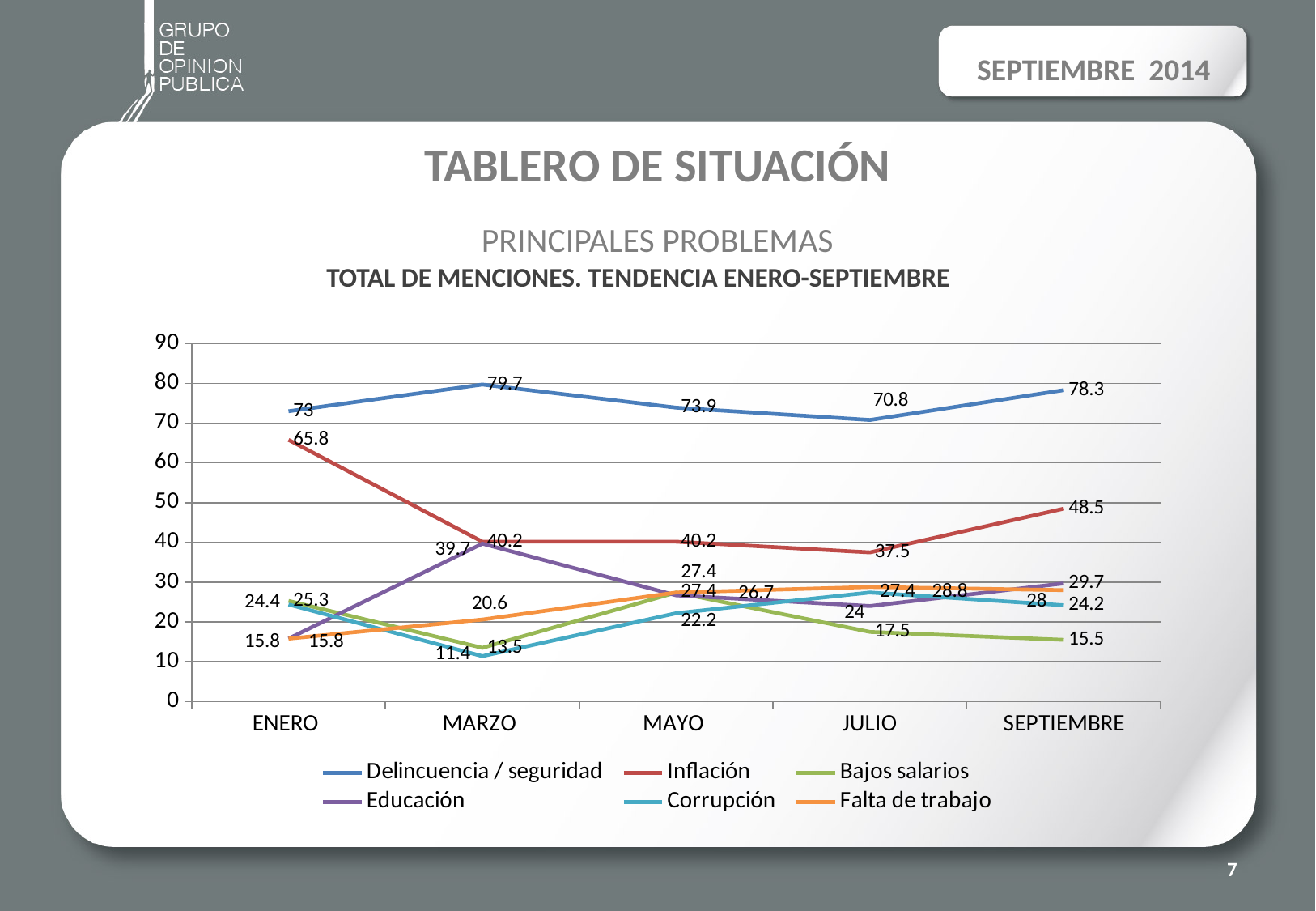
Which series has the higher value in ENERO, Delincuencia / seguridad or Inflación? Delincuencia / seguridad How many series does the legend list? 6 What is the value for Educación in MARZO? 39.7 Does the Inflación line rise or fall from ENERO to MARZO? Fall What type of chart is shown on the slide? Line chart What is the value for Delincuencia / seguridad in MARZO? 79.7 How many months are plotted along the x axis? 5 What is the value for Bajos salarios in SEPTIEMBRE? 15.5 In which month does Delincuencia / seguridad reach its lowest value? JULIO What is the value for Inflación in SEPTIEMBRE? 48.5 What is the difference between the Delincuencia / seguridad values in MARZO and JULIO? 8.9 In which month does Inflación reach its highest value? ENERO